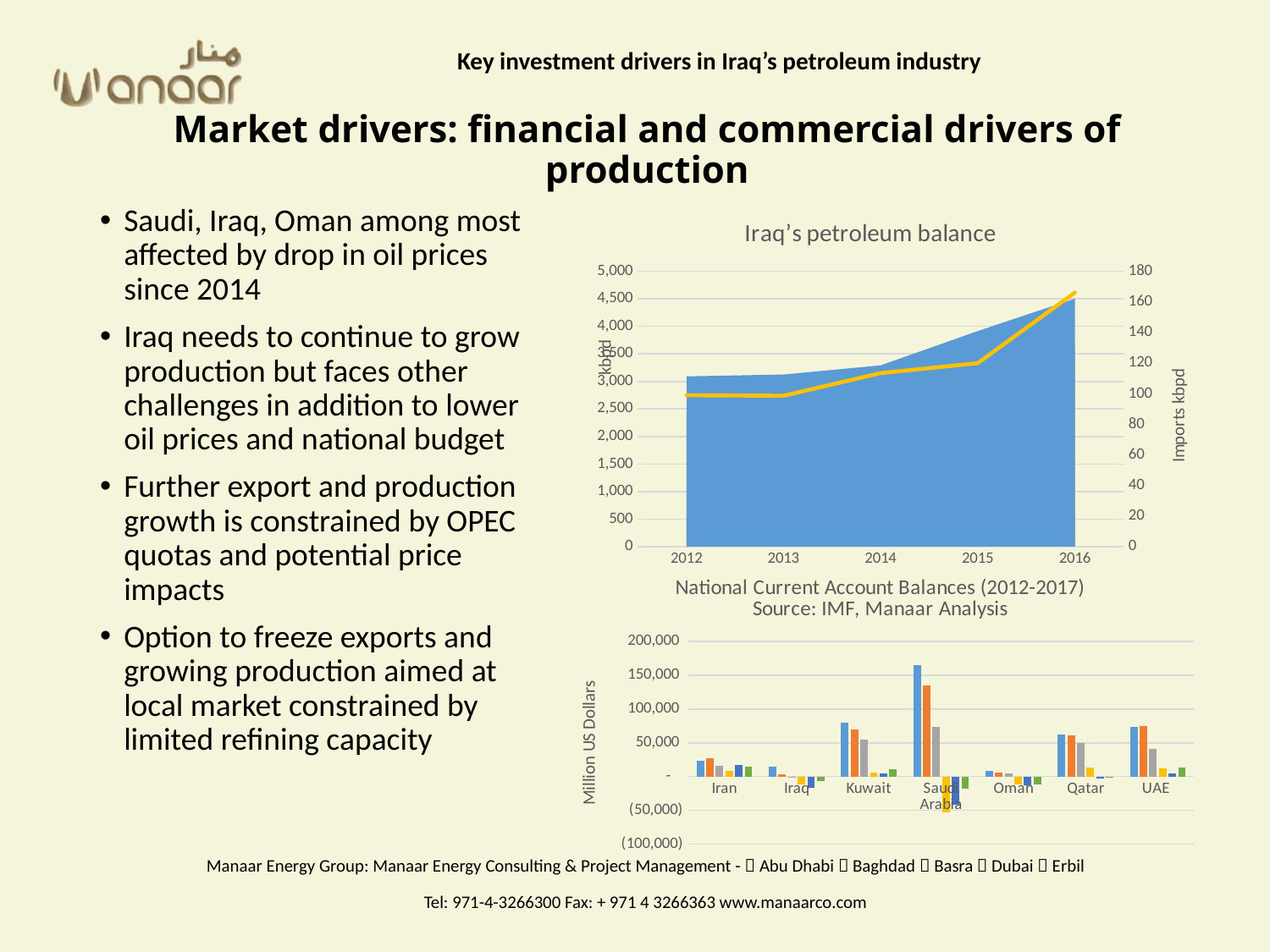
In the Iraq's petroleum balance chart, is the blue area value for 2012 greater or less than 3,500? less What kind of chart is the National Current Account Balances (2012-2017) chart? bar chart How many countries are shown on the x axis of the National Current Account Balances (2012-2017) chart? 7 In the Iraq's petroleum balance chart, does the blue area rise or fall from 2012 to 2016? rise What is the title of the top chart on the slide? Iraq's petroleum balance In the Iraq's petroleum balance chart, is the blue area value for 2016 greater or less than 4,000? greater What is the y-axis label of the National Current Account Balances (2012-2017) chart? Million US Dollars In the Iraq's petroleum balance chart, is the yellow line value for 2016 on the right axis greater or less than 140? greater In the National Current Account Balances (2012-2017) chart, which country has the tallest bar? Saudi Arabia In the National Current Account Balances (2012-2017) chart, which country has a taller tallest bar, Kuwait or Qatar? Kuwait How many years are shown on the x axis of the Iraq's petroleum balance chart? 5